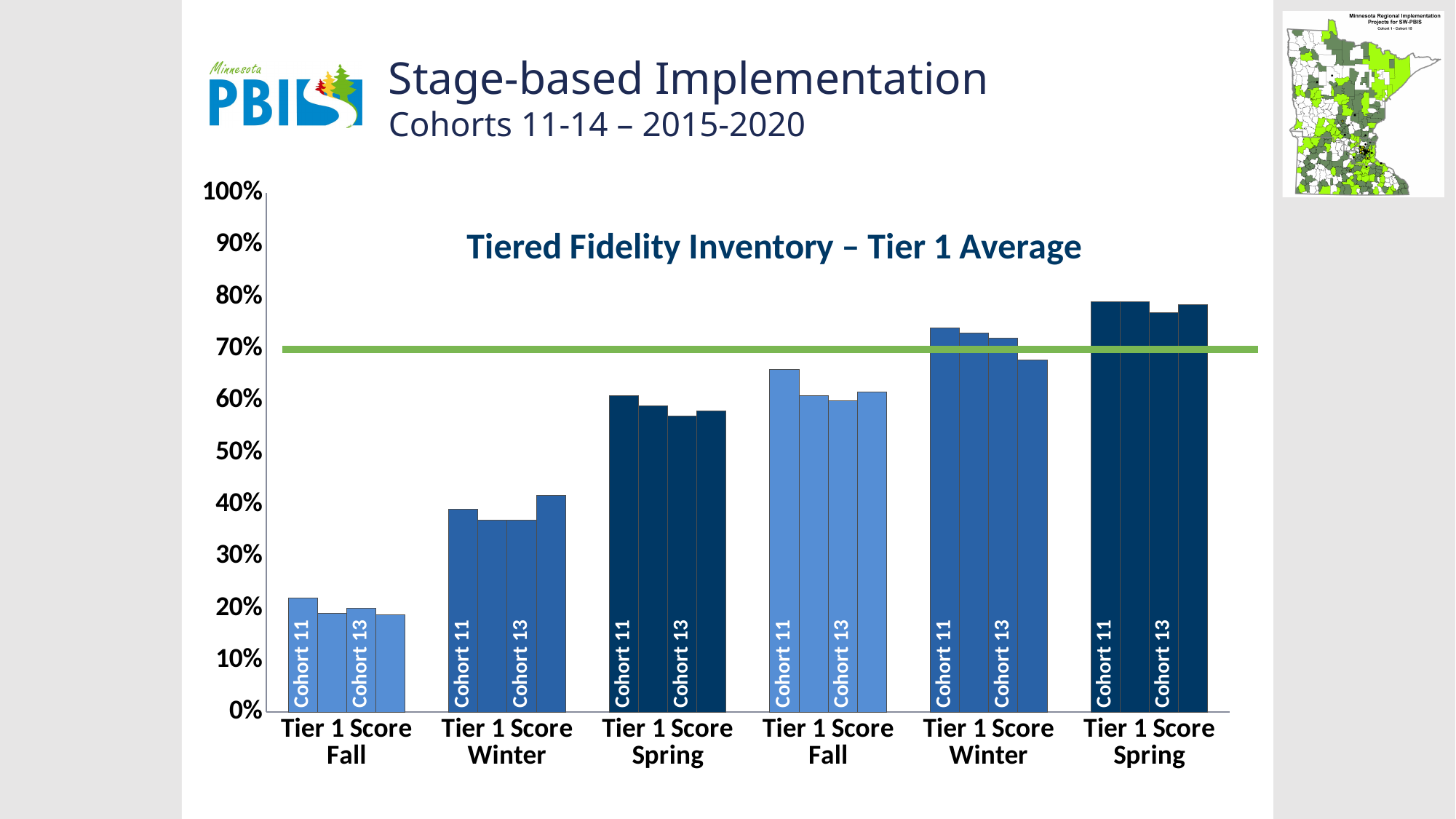
What kind of chart is shown on the slide? bar chart At what value does the horizontal green line sit? 70% Is the Cohort 11 value in the first Tier 1 Score Fall group greater or less than 30%? less Is the Cohort 11 value in the first Tier 1 Score Spring group greater or less than 50%? greater Is the Cohort 11 value in the second Tier 1 Score Fall group greater or less than 70%? less Which category group has the lowest bars? Tier 1 Score Fall (the leftmost group) How many category groups are shown along the x axis? 6 How many bars are in each category group? 4 What is the title of the chart? Tiered Fidelity Inventory – Tier 1 Average Which category group has the highest bars? Tier 1 Score Spring (the rightmost group) Do the values generally rise or fall moving from left to right along the x axis? rise